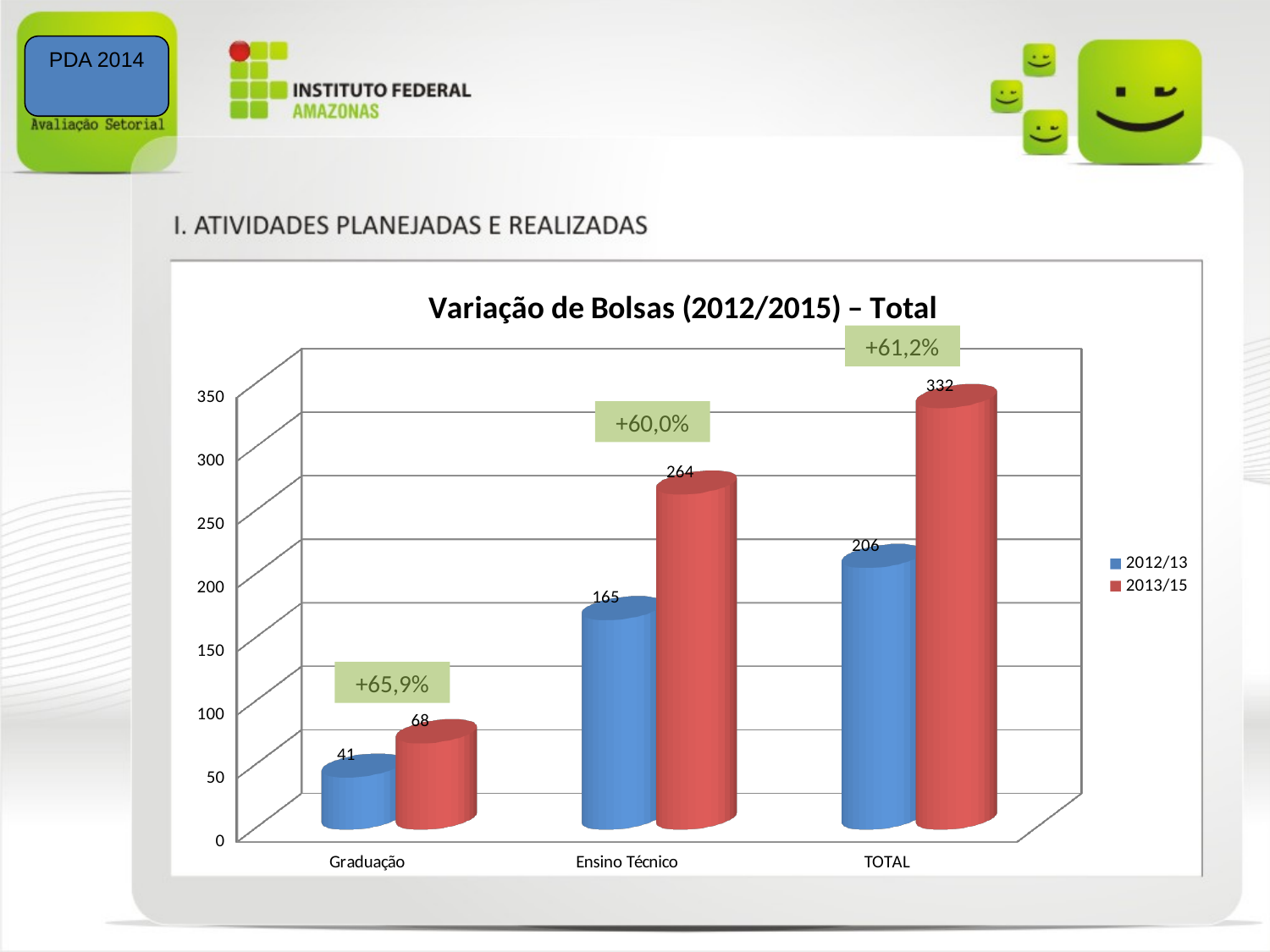
What is the difference between the 2013/15 and 2012/13 values for Ensino Técnico? 99 What kind of chart is shown on the slide? Bar chart Which category has the lowest value in the 2013/15 series? Graduação What is the value for TOTAL in the 2012/13 series? 206 What is the value for Ensino Técnico in the 2013/15 series? 264 What is the value for Graduação in the 2012/13 series? 41 Which is larger for Graduação: the 2012/13 value or the 2013/15 value? 2013/15 What is the value for TOTAL in the 2013/15 series? 332 How many series does the legend list? 2 How many categories are shown on the x axis? 3 What percentage change is shown above the TOTAL bars? +61,2% Which category has the highest value in the 2012/13 series? TOTAL